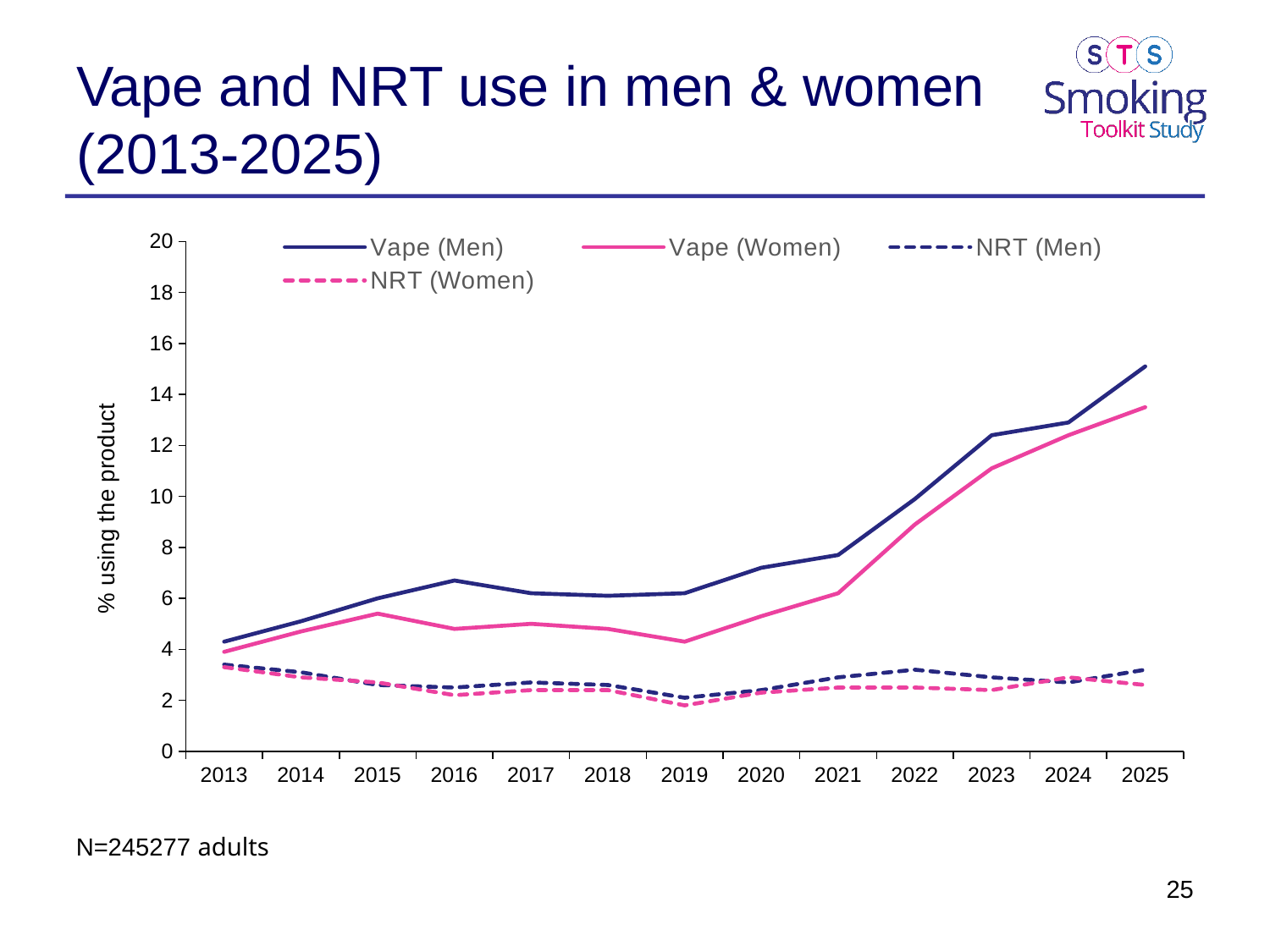
How many years are shown along the x axis? 13 How many series does the legend list? 4 In 2016, which is larger: Vape (Women) or NRT (Women)? Vape (Women) Does Vape (Men) rise or fall from 2021 to 2025? rise Is the value for Vape (Men) in 2025 greater or less than 14? greater In which year is NRT (Women) at its lowest? 2019 In 2023, which is larger: Vape (Men) or Vape (Women)? Vape (Men) In which year is Vape (Men) at its highest? 2025 What kind of chart is shown on the slide? line chart Is the value for Vape (Women) in 2019 greater or less than 6? less What is the title of the y axis? % using the product Is the value for NRT (Men) in 2013 greater or less than 4? less